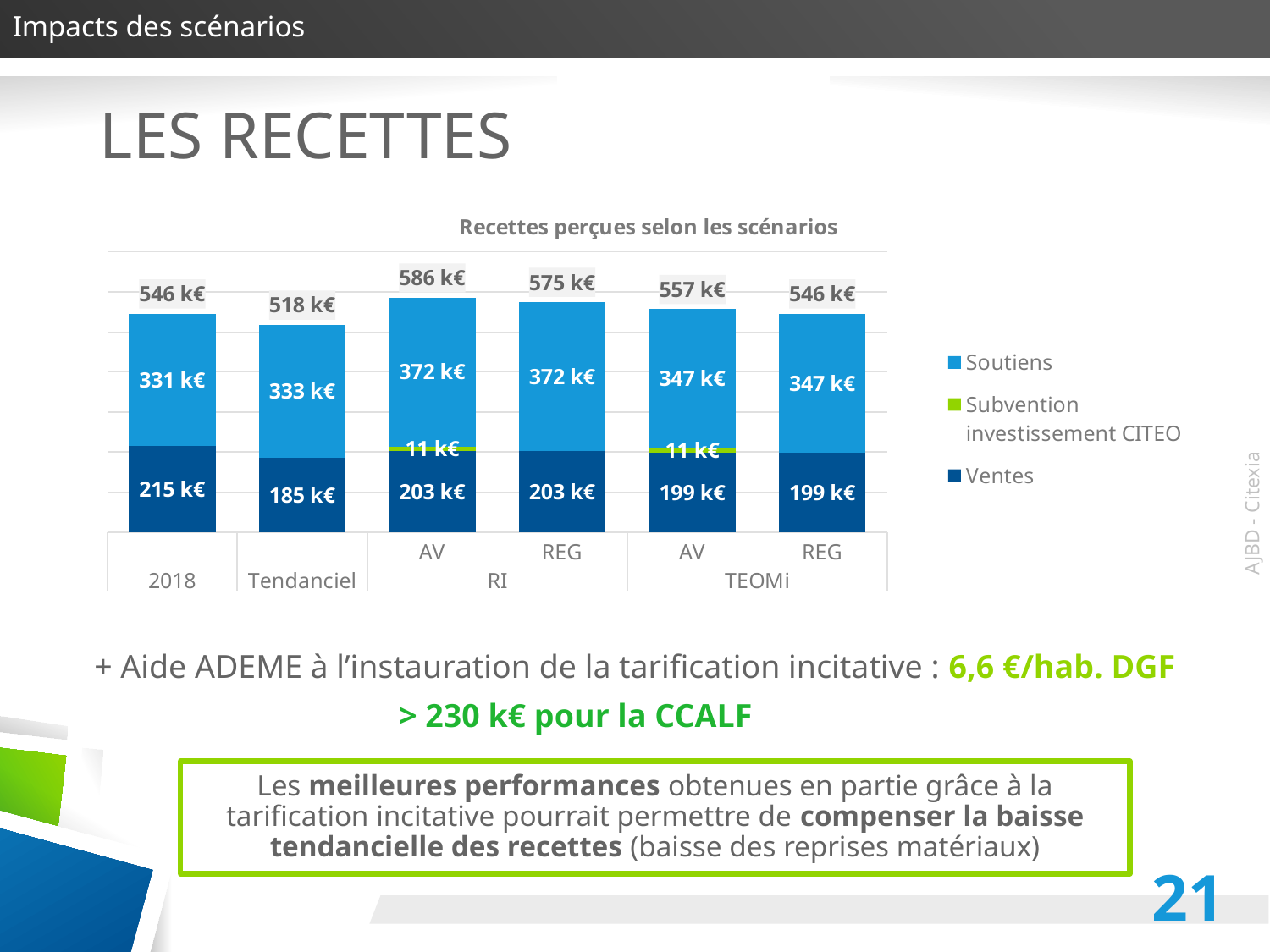
What is the title of the chart? Recettes perçues selon les scénarios Which is larger, the Soutiens value for RI REG or the Soutiens value for TEOMi REG? RI REG How many bars are plotted in the chart? 6 What is the total of the RI AV stacked bar? 586 k€ What is the difference between the Ventes value for 2018 and the Ventes value for Tendanciel? 30 k€ What is the Subvention investissement CITEO value for the RI AV bar? 11 k€ What kind of chart is shown on the slide? Stacked bar chart How many series does the chart legend list? 3 What is the Ventes value for the 2018 bar? 215 k€ Which scenario has the lowest total recettes? Tendanciel What is the Soutiens value for the Tendanciel bar? 333 k€ Which scenario has the highest total recettes? RI AV